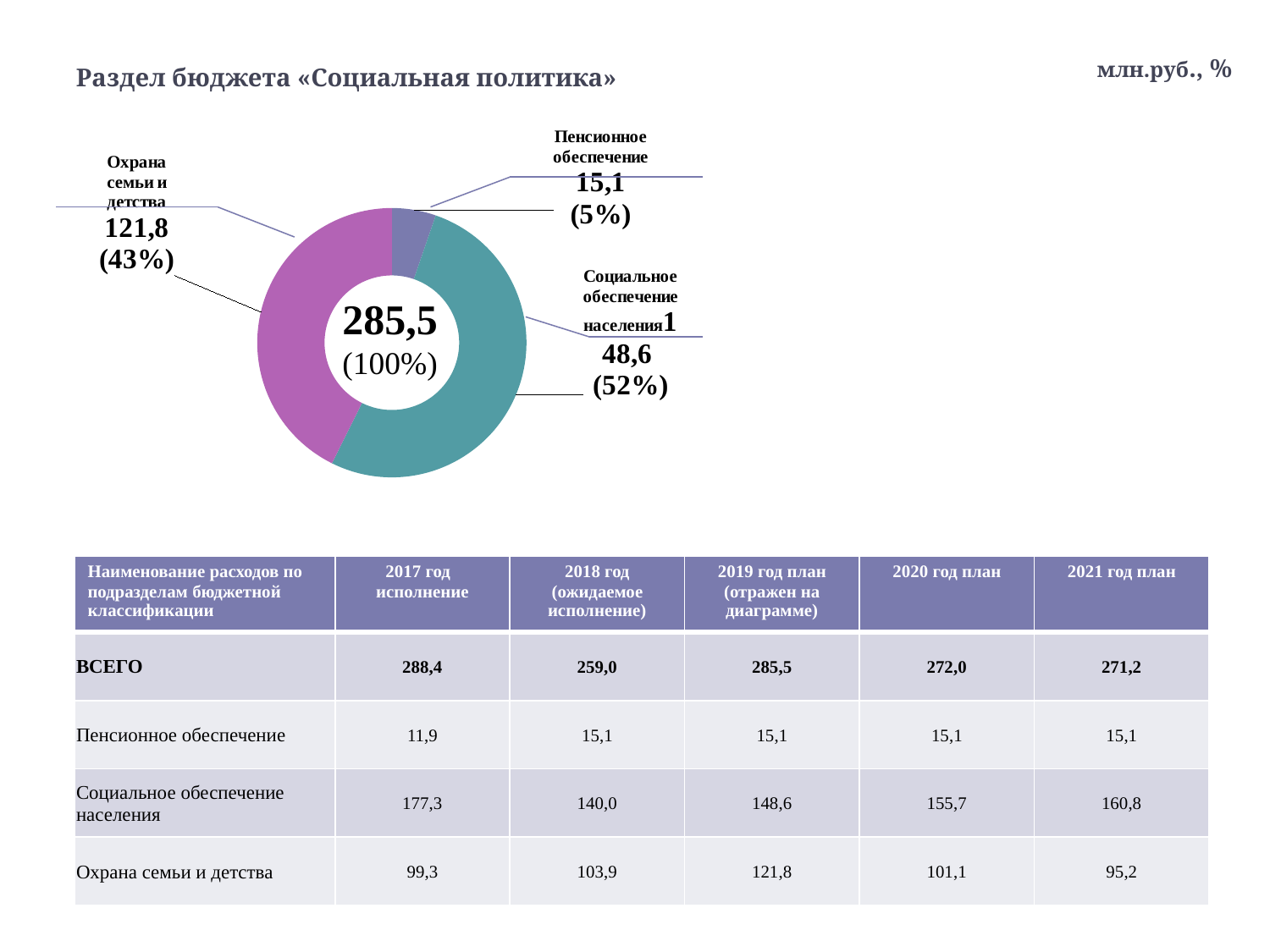
On the donut chart, which is larger: Охрана семьи и детства or Пенсионное обеспечение? Охрана семьи и детства What is the difference between the values for Охрана семьи и детства and Пенсионное обеспечение on the donut chart? 106,7 Which slice of the donut chart is the smallest? Пенсионное обеспечение What value is shown in the centre of the donut chart? 285,5 What kind of chart is shown on the slide? Donut (pie) chart What share of the donut chart does Пенсионное обеспечение take? 5% What share of the donut chart does Социальное обеспечение населения take? 52% What is the value for Пенсионное обеспечение on the donut chart? 15,1 How many slices does the donut chart have? 3 Which slice of the donut chart is the largest? Социальное обеспечение населения What share of the donut chart does Охрана семьи и детства take? 43% What is the value for Охрана семьи и детства on the donut chart? 121,8